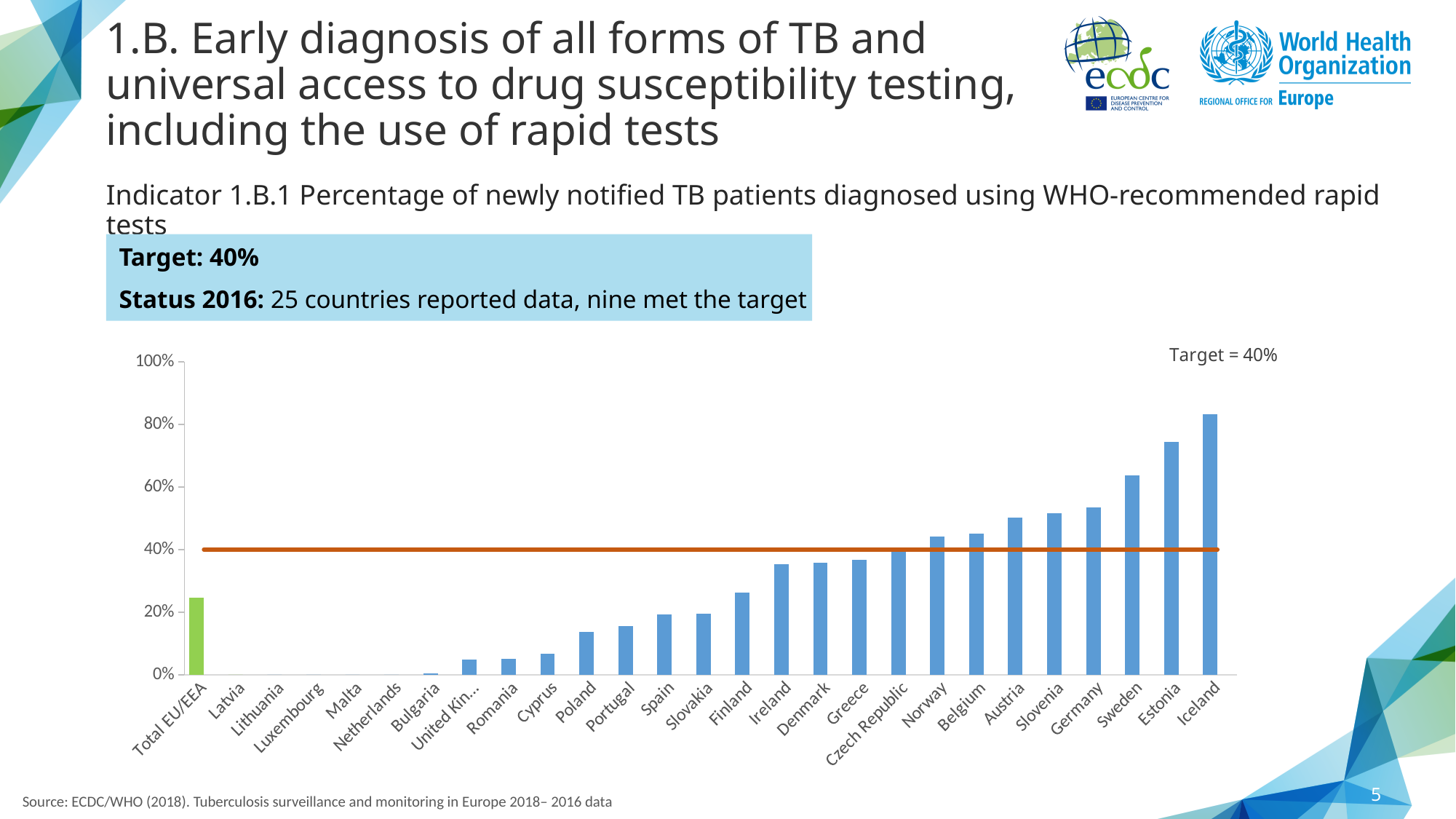
Is the value for Poland greater or less than 20%? less Is the value for Iceland greater or less than 80%? greater What colour is the bar for Total EU/EEA? Green Is the value for Ireland greater or less than 40%? less Do the bar values generally rise or fall from left to right along the x axis? Rise Which country has the highest percentage of newly notified TB patients diagnosed using WHO-recommended rapid tests? Iceland What kind of chart is shown on the slide? Bar chart What value does the horizontal target line on the chart represent? 40% Which has a higher value, Estonia or Sweden? Estonia